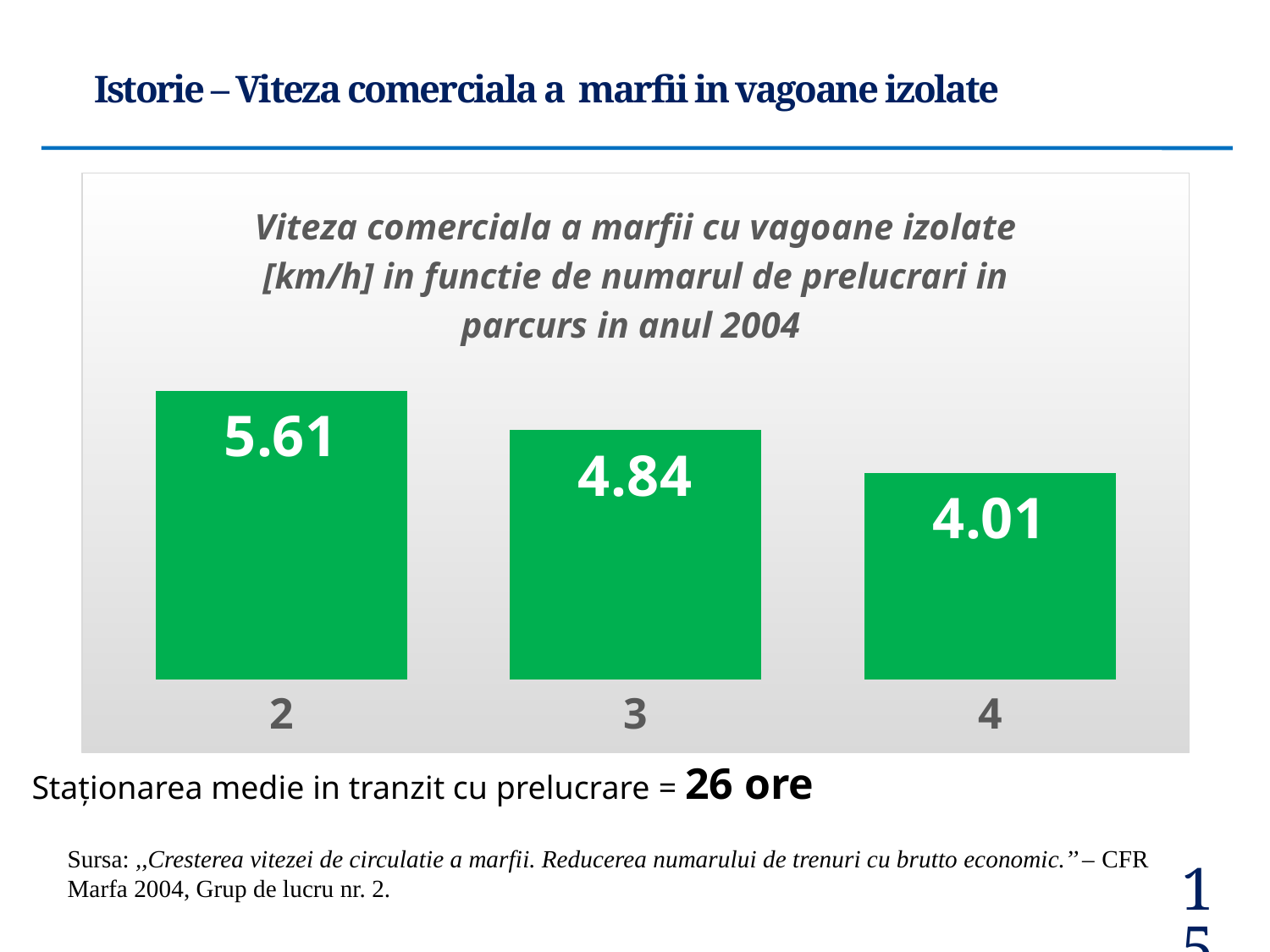
What is the value for category 3? 4.84 What is the value for category 4? 4.01 What kind of chart is shown on the slide? bar chart What is the value for category 2? 5.61 Which category has the highest value? 2 What is the difference between the values for category 2 and category 3? 0.77 What colour are the bars in the chart? green Which is larger, the value for category 3 or the value for category 4? 3 Do the values rise or fall as the number of processings increases from 2 to 4? fall Which category has the lowest value? 4 How many bars are shown in the chart? 3 What is the difference between the values for category 2 and category 4? 1.60